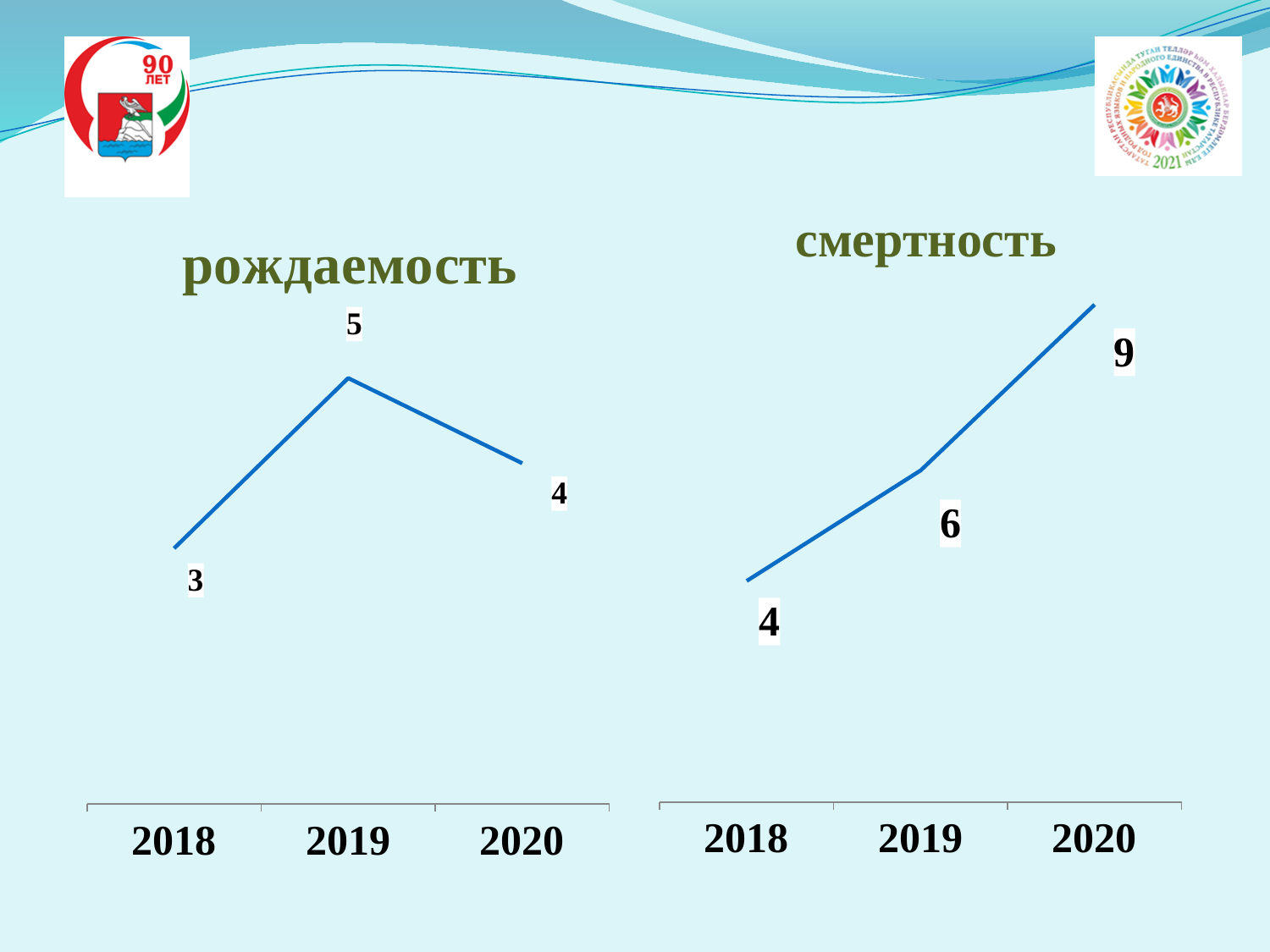
In the смертность chart, which year has the lowest value? 2018 In the рождаемость chart, which year has the highest value? 2019 In the рождаемость chart, what is the difference between the values for 2019 and 2020? 1 In the смертность chart, what is the value for 2020? 9 In the смертность chart, what is the difference between the values for 2020 and 2018? 5 In the смертность chart, which is larger, the value for 2019 or the value for 2018? 2019 In the рождаемость chart, what is the value for 2018? 3 What kind of chart is the смертность chart? line chart In the рождаемость chart, what is the value for 2019? 5 In the смертность chart, what is the value for 2019? 6 How many years are plotted in the рождаемость chart? 3 In the смертность chart, do the values rise or fall from 2018 to 2020? rise